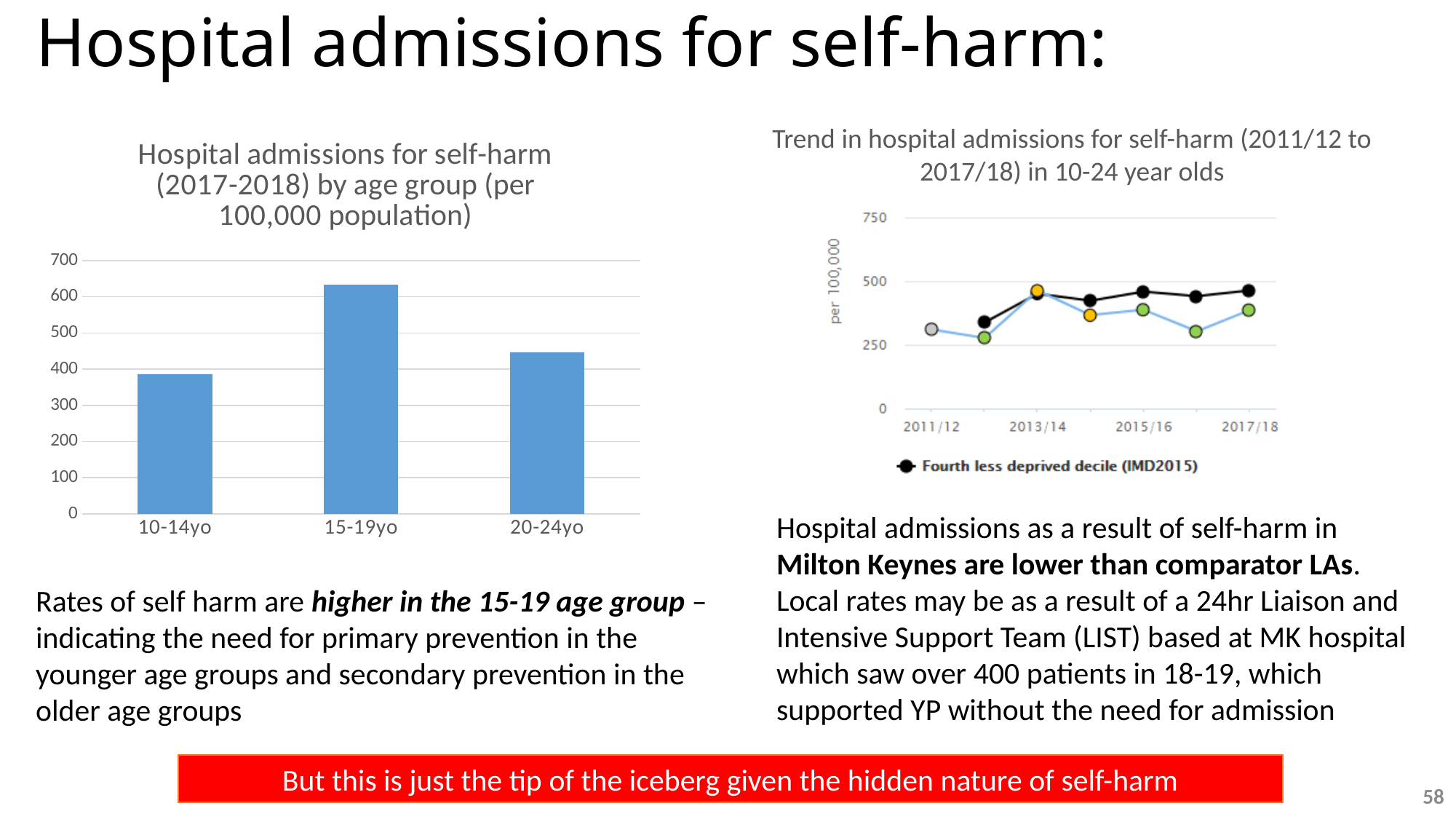
In the left bar chart, is the value for 20-24yo greater or less than 500? less In the left bar chart, is the value for 15-19yo greater or less than 600? greater In the left bar chart, which has a higher value: 20-24yo or 10-14yo? 20-24yo In the right line chart, is the value for the Fourth less deprived decile (IMD2015) series in 2017/18 greater or less than 500? less What kind of chart is the left chart, 'Hospital admissions for self-harm (2017-2018) by age group'? Bar chart In the left bar chart, what unit are the rates expressed in according to the chart title? per 100,000 population What kind of chart is the right chart, 'Trend in hospital admissions for self-harm (2011/12 to 2017/18) in 10-24 year olds'? Line chart In the left bar chart, how many age groups are shown? 3 In the right line chart, how many series does the legend list? 1 In the left bar chart, which age group has the highest rate of hospital admissions for self-harm? 15-19yo In the left bar chart, which age group has the lowest rate of hospital admissions for self-harm? 10-14yo